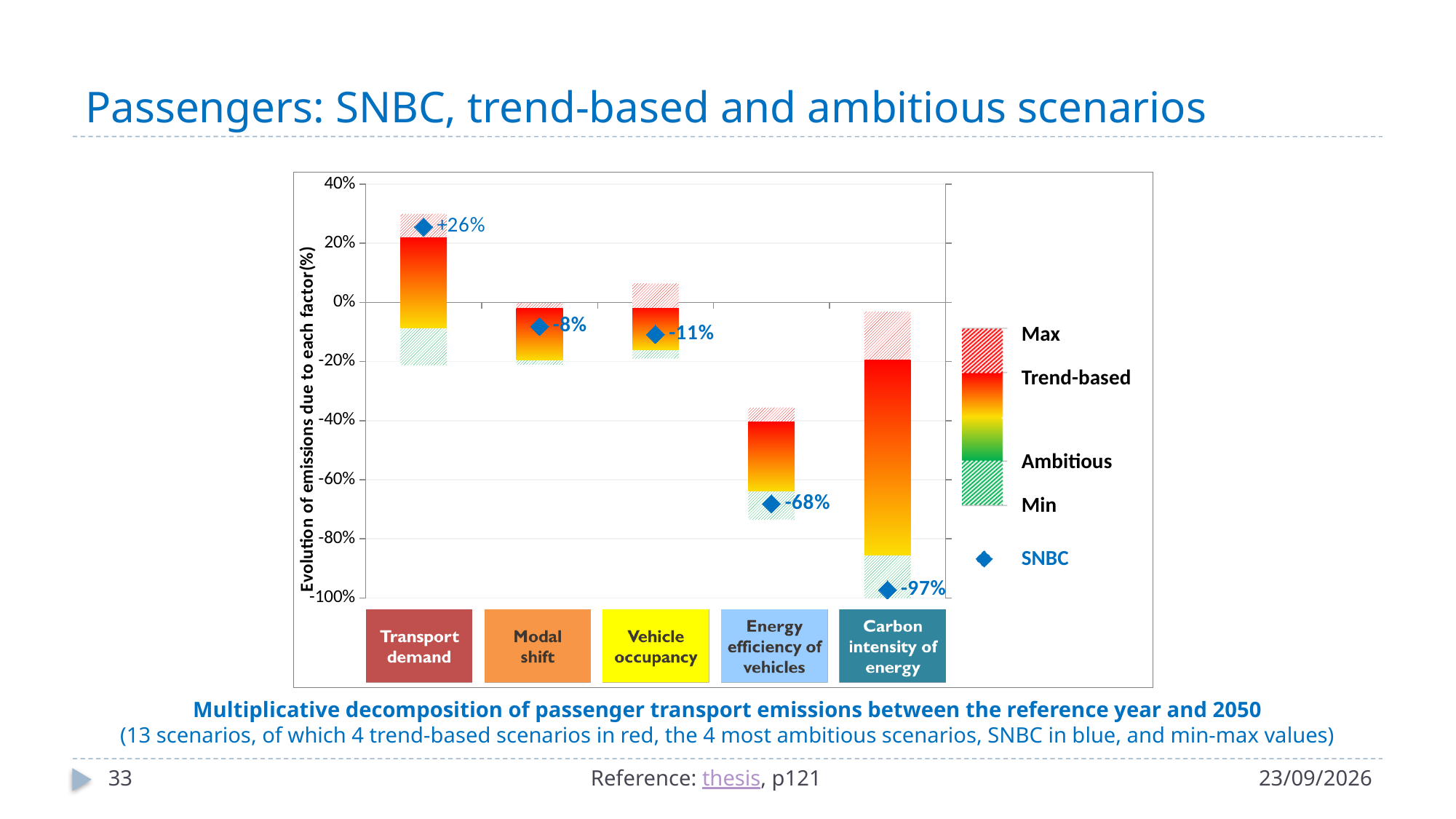
How many entries does the legend list? 5 What is the SNBC value for Vehicle occupancy? -11% Which factor has the lowest SNBC value? Carbon intensity of energy What is the SNBC value for Energy efficiency of vehicles? -68% What is the SNBC value for Modal shift? -8% What is the difference between the SNBC values for Transport demand and Modal shift? 34 percentage points What is the SNBC value for Transport demand? +26% Which factor has the highest SNBC value? Transport demand Is the Max value for Transport demand greater or less than 20%? greater Which has the larger SNBC value, Modal shift or Vehicle occupancy? Modal shift What is the SNBC value for Carbon intensity of energy? -97% How many factors are shown on the x axis? 5